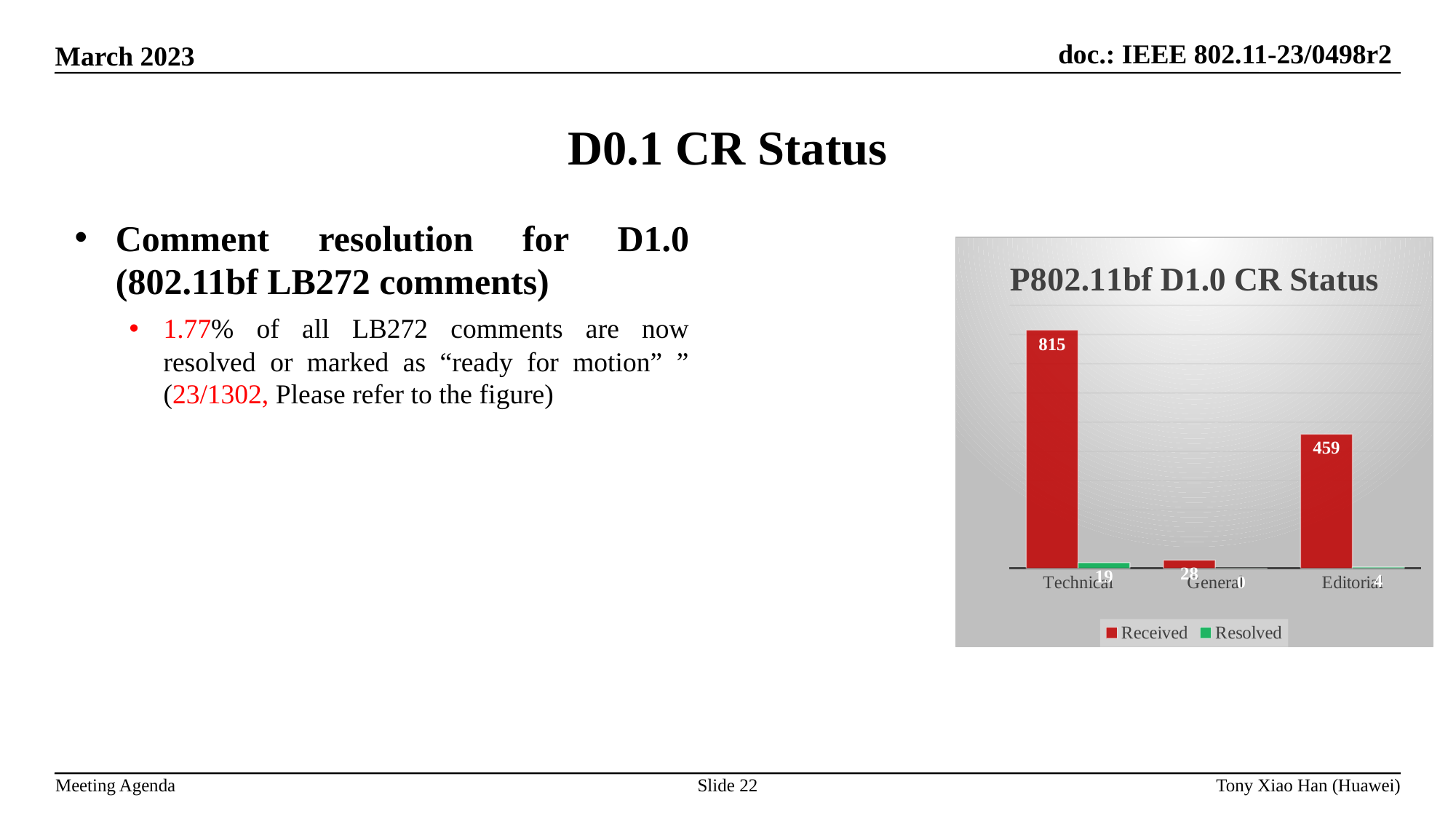
Which category has the highest Received value? Technical What is the title of the chart? P802.11bf D1.0 CR Status Which is larger, the Resolved value for Technical or the Resolved value for Editorial? Technical How many categories are shown on the x axis? 3 How many series does the legend list? 2 What is the Resolved value for Technical? 19 What is the Received value for Editorial? 459 What is the difference between the Received values for Technical and Editorial? 356 What is the Resolved value for General? 0 What is the Received value for Technical? 815 Which category has the lowest Received value? General What is the Received value for General? 28